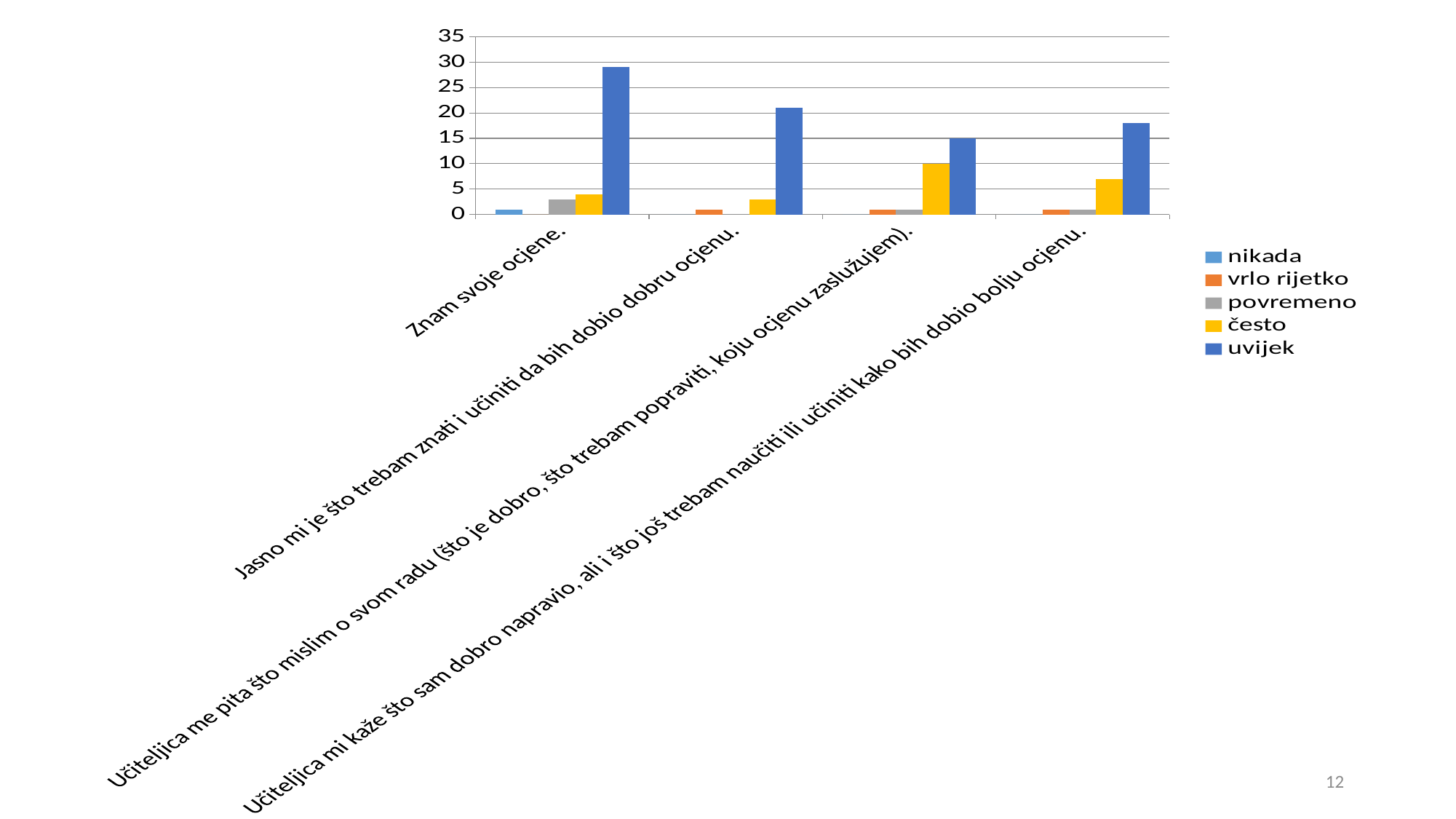
Is the 'uvijek' value for 'Znam svoje ocjene.' greater or less than 25? greater Is the 'često' value for 'Učiteljica mi kaže što sam dobro napravio, ali i što još trebam naučiti ili učiniti kako bih dobio bolju ocjenu.' greater or less than 5? greater Which category has a larger 'često' bar: 'Znam svoje ocjene.' or 'Učiteljica me pita što mislim o svom radu (što je dobro, što trebam popraviti, koju ocjenu zaslužujem).'? Učiteljica me pita što mislim o svom radu (što je dobro, što trebam popraviti, koju ocjenu zaslužujem). Which category has the lowest 'uvijek' bar? Učiteljica me pita što mislim o svom radu (što je dobro, što trebam popraviti, koju ocjenu zaslužujem). For 'Učiteljica me pita što mislim o svom radu (što je dobro, što trebam popraviti, koju ocjenu zaslužujem).', which is larger: 'često' or 'uvijek'? uvijek What kind of chart is shown on the slide? bar chart What is the 'uvijek' value for 'Učiteljica me pita što mislim o svom radu (što je dobro, što trebam popraviti, koju ocjenu zaslužujem).'? 15 How many categories are shown along the x axis? 4 What colour represents the 'često' series in the legend? yellow How many series does the legend list? 5 Which category has the highest 'uvijek' bar? Znam svoje ocjene.